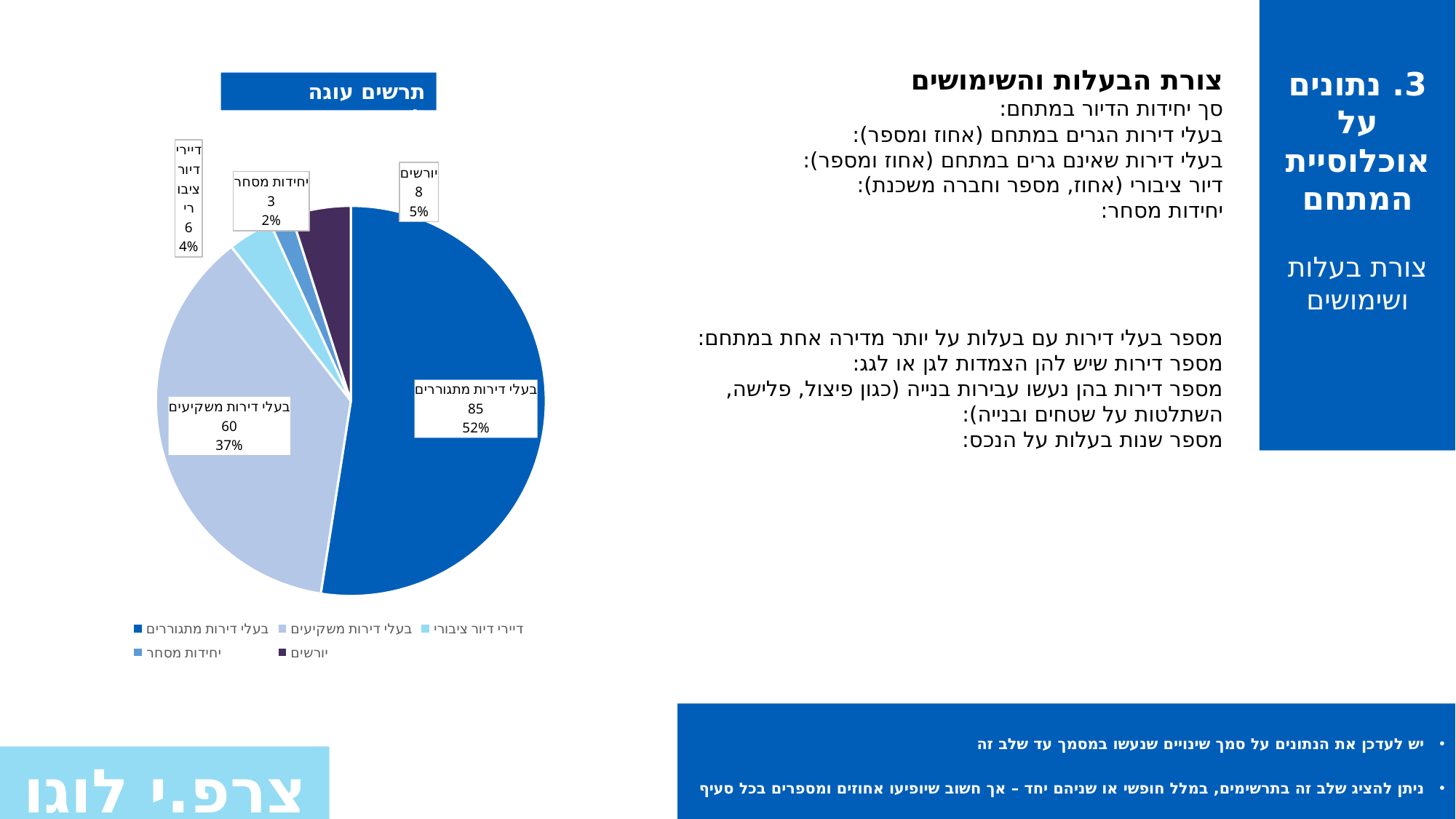
Which category has the smallest slice in the pie chart? יחידות מסחר What is the value for בעלי דירות משקיעים in the pie chart? 60 What is the value for בעלי דירות מתגוררים in the pie chart? 85 What is the value for יחידות מסחר in the pie chart? 3 What is the difference between the values for בעלי דירות מתגוררים and בעלי דירות משקיעים? 25 What kind of chart is shown on the slide? pie chart Which category has the largest slice in the pie chart? בעלי דירות מתגוררים What share of the pie does דיירי דיור ציבורי represent? 4% How many slices does the pie chart have? 5 What is the value for יורשים in the pie chart? 8 How many entries does the legend of the pie chart list? 5 What share of the pie does בעלי דירות משקיעים represent? 37%